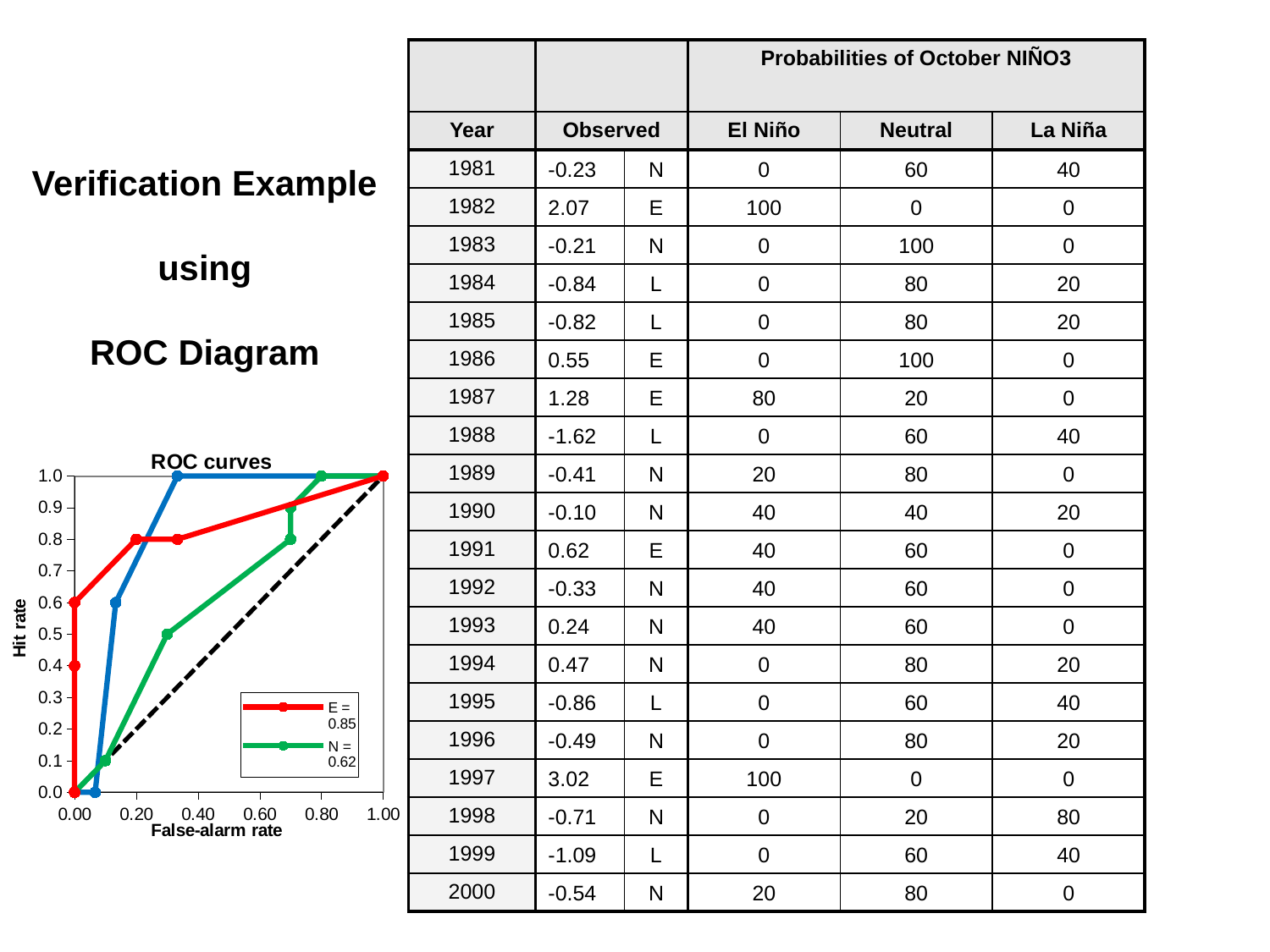
In the ROC curves chart, is the hit rate of the green N curve at a false-alarm rate of 0.20 greater or less than 0.5? less In the ROC curves chart, is the hit rate of the red E curve at a false-alarm rate of 0.60 greater or less than 0.8? greater What is the title of the chart on the slide? ROC curves In the ROC curves chart, what is the hit rate of the red E curve at a false-alarm rate of 0.20? 0.8 How many series does the legend of the ROC curves chart list? 2 In the ROC curves chart, is the hit rate of the green N curve at a false-alarm rate of 0.60 greater or less than 0.6? greater In the ROC curves chart, at a false-alarm rate of 0.20, which curve has the higher hit rate, the red E curve or the green N curve? red E curve In the ROC curves chart, does the hit rate of the green N curve rise or fall as the false-alarm rate increases? rise In the ROC curves chart, what is the hit rate of the green N curve at a false-alarm rate of 0.80? 1.0 In the ROC curves chart, which legend entry has the higher value, E or N? E What value is shown for E in the legend of the ROC curves chart? 0.85 What kind of chart is the ROC curves chart? line chart